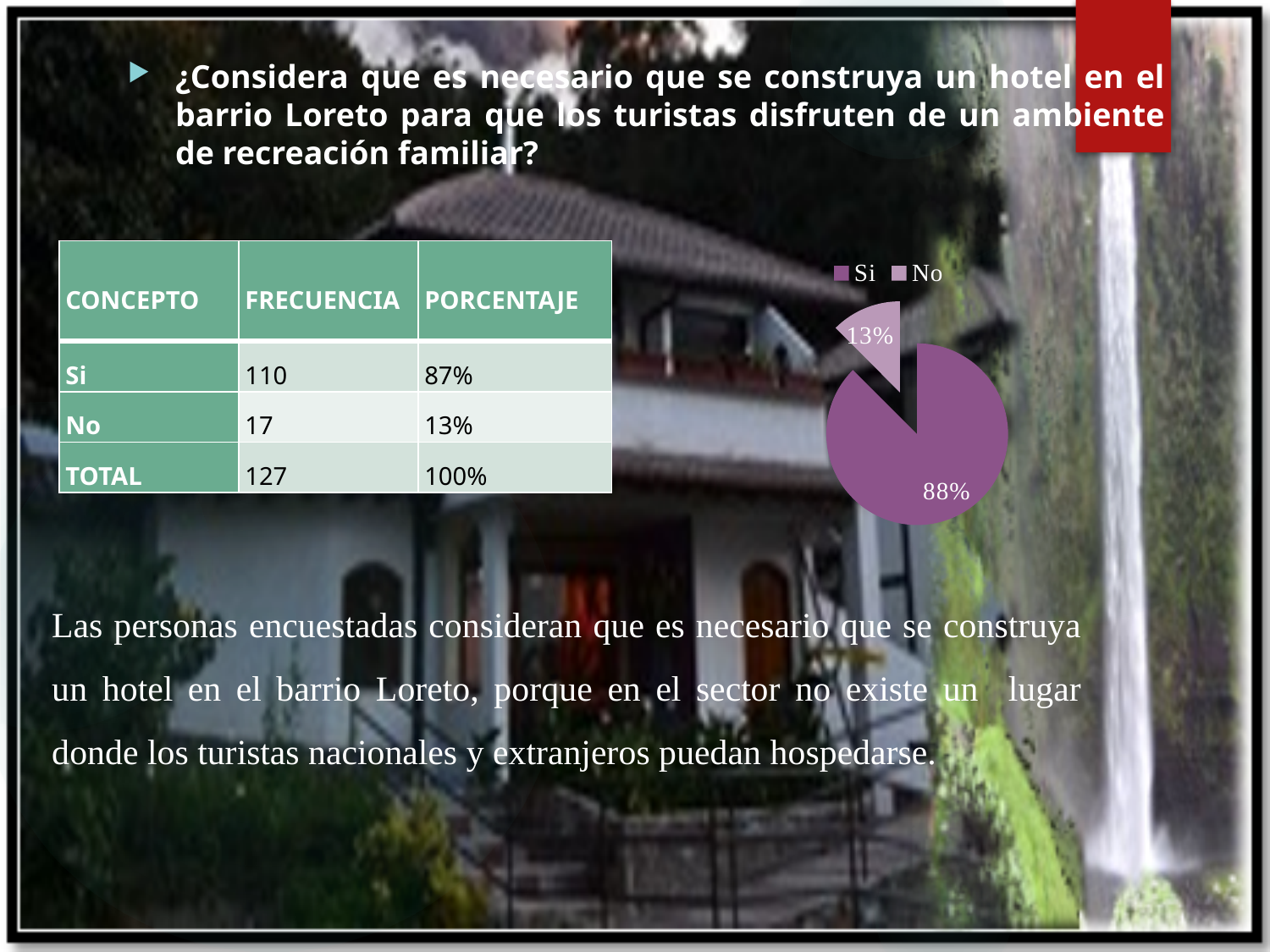
In the pie chart, which is larger, the Si slice or the No slice? Si What share of the pie chart does the No slice represent, according to its data label? 13% How many entries does the pie chart's legend list? 2 Which slice of the pie chart is the largest? Si What are the two entries in the pie chart's legend? Si and No What percentage does the pie chart show for Si? 88% What kind of chart is shown on the slide? pie chart Which slice of the pie chart is the smallest? No How many slices does the pie chart have? 2 What percentage does the pie chart show for No? 13% Which legend entry in the pie chart is shown in the darker purple colour? Si